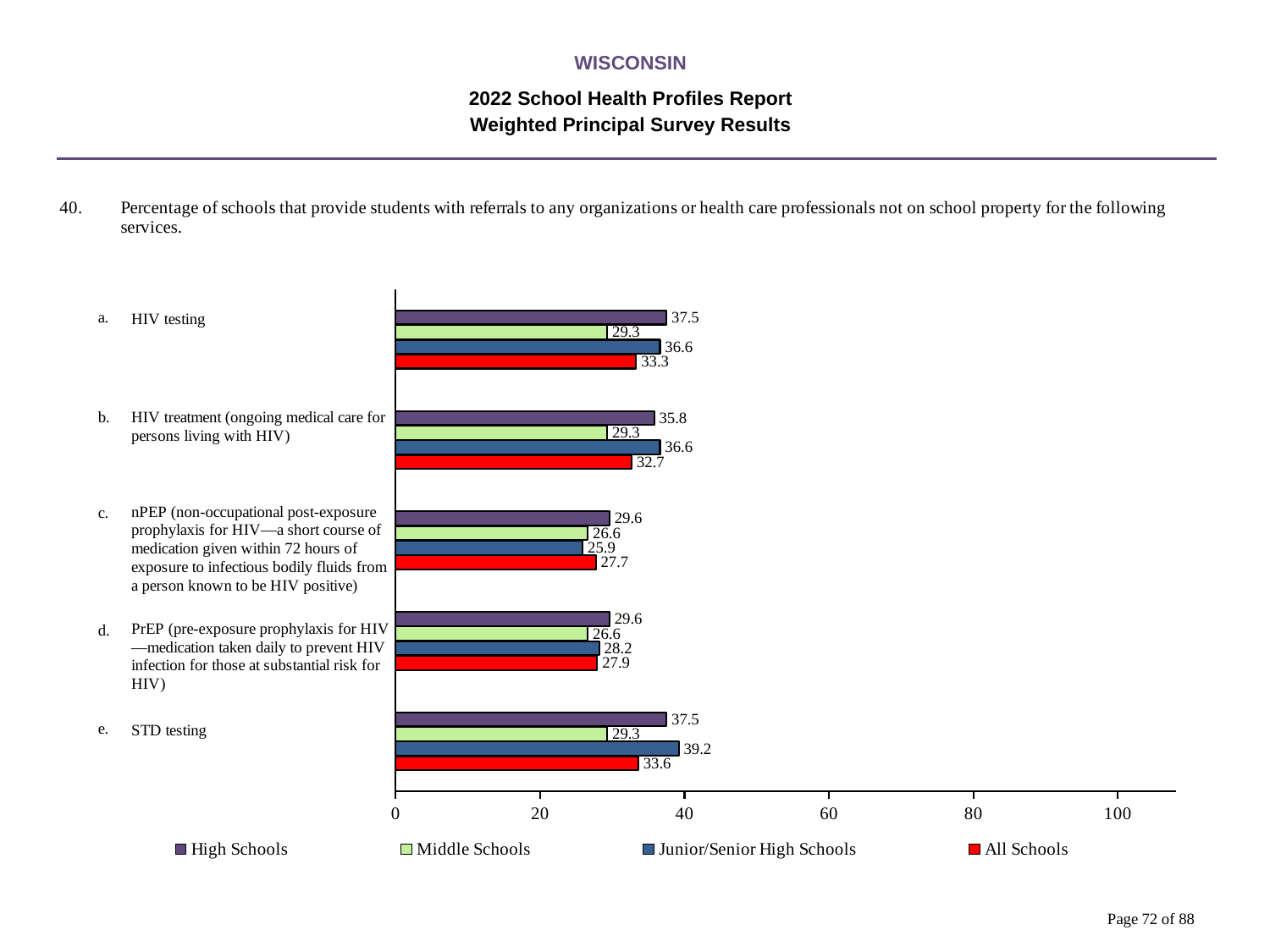
Which service has the lowest value for All Schools? nPEP What is the value for All Schools for HIV treatment (ongoing medical care for persons living with HIV)? 32.7 Which service has the highest value for Junior/Senior High Schools? STD testing How many services (categories) are shown in the chart? 5 Is the value for Junior/Senior High Schools for STD testing greater or less than 40? less What is the difference between the High Schools and Middle Schools values for HIV testing? 8.2 What is the value for High Schools for HIV testing? 37.5 Which is larger for nPEP: the Middle Schools value or the Junior/Senior High Schools value? Middle Schools What kind of chart is shown on the slide? Bar chart How many series does the legend list? 4 What is the value for Middle Schools for PrEP? 26.6 What is the value for Junior/Senior High Schools for STD testing? 39.2